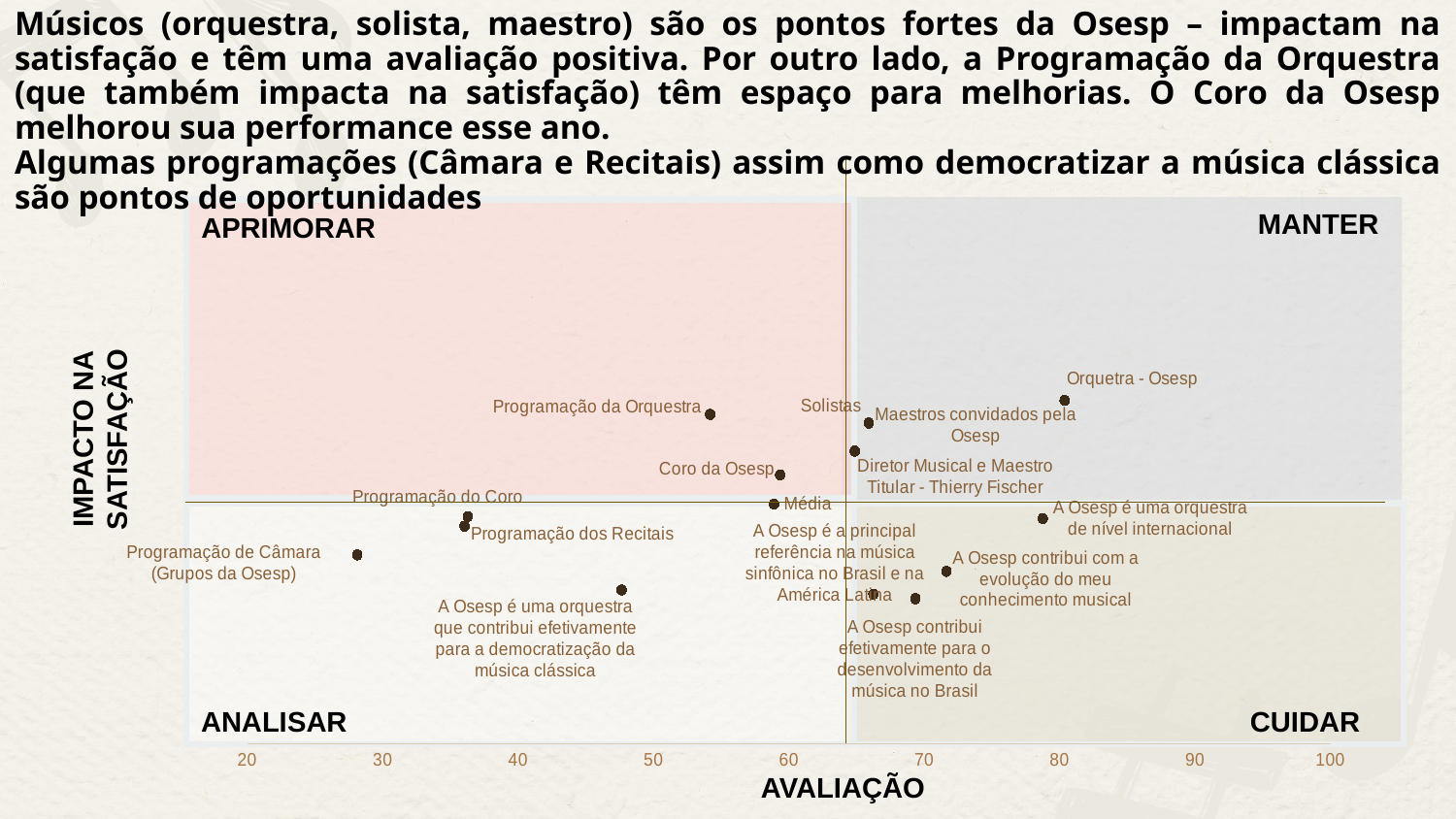
Which has a higher AVALIAÇÃO value, Programação da Orquestra or Programação de Câmara (Grupos da Osesp)? Programação da Orquestra Is the AVALIAÇÃO value for Programação da Orquestra greater or less than 60? less Is the AVALIAÇÃO value for Solistas greater or less than 60? greater Which point has the highest IMPACTO NA SATISFAÇÃO value on the chart? Orquetra - Osesp Is the AVALIAÇÃO value for Programação dos Recitais greater or less than 40? less What is the title of the vertical axis of the chart? IMPACTO NA SATISFAÇÃO Which point has the lowest AVALIAÇÃO value on the chart? Programação de Câmara (Grupos da Osesp) What is the title of the horizontal axis of the chart? AVALIAÇÃO Which has a higher AVALIAÇÃO value, Orquetra - Osesp or Programação do Coro? Orquetra - Osesp What kind of chart is shown on the slide? scatter chart